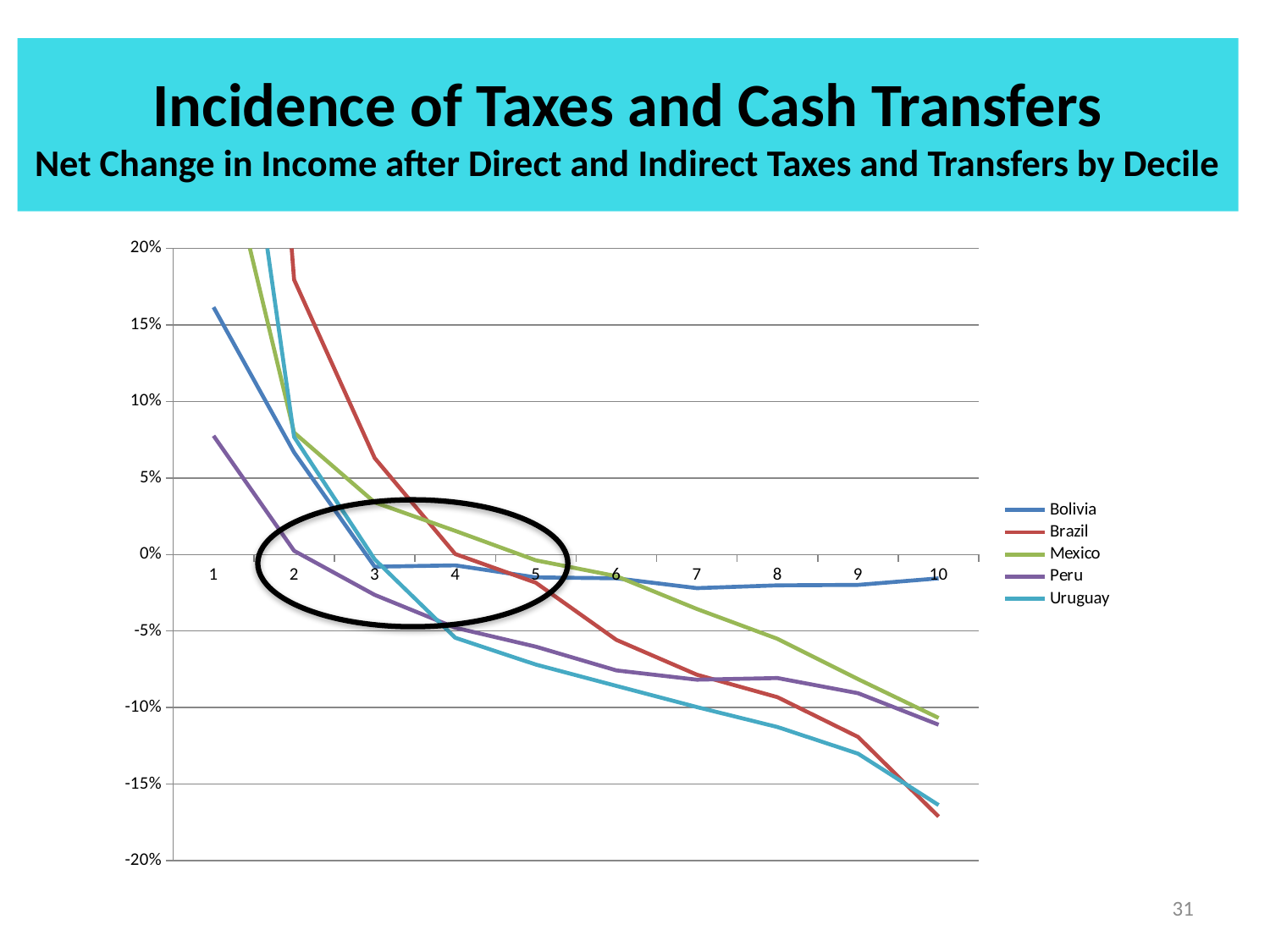
Is the value for Bolivia at decile 1 greater or less than 15%? greater Which countries are listed in the legend? Bolivia, Brazil, Mexico, Peru, Uruguay Which country has the highest value at decile 10? Bolivia How many deciles are shown along the x axis? 10 Is the value for Brazil at decile 10 greater or less than -15%? less Which country has the highest value at decile 2? Brazil What kind of chart is shown on the slide? line chart Do the values for Brazil rise or fall as the decile increases from 1 to 10? fall How many series does the legend list? 5 Is the value for Peru at decile 1 greater or less than 5%? greater At decile 3, which is larger, the value for Brazil or the value for Peru? Brazil